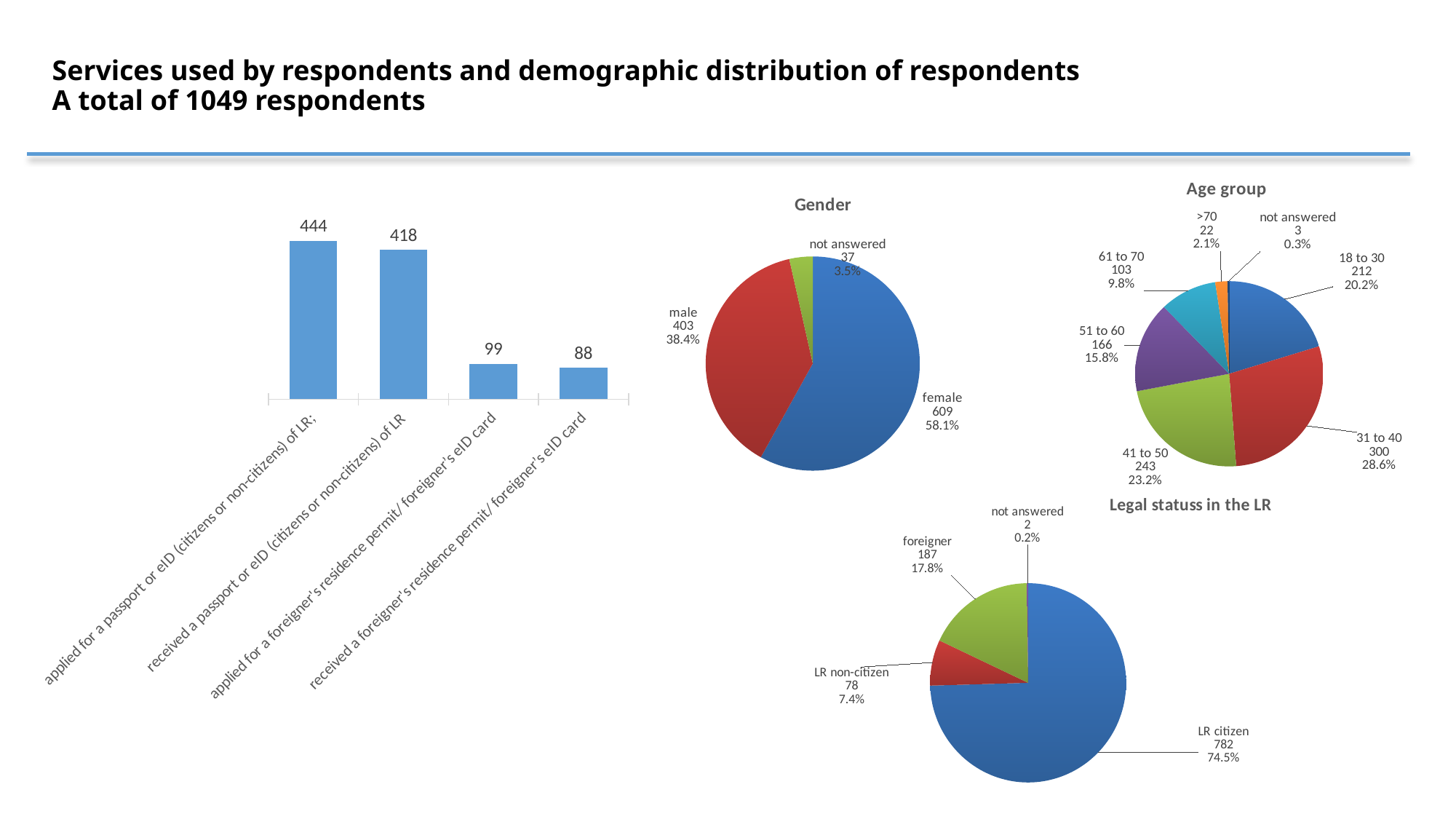
In the 'Legal statuss in the LR' pie chart, how many slices are there? 4 In the 'Legal statuss in the LR' pie chart, what share of respondents are LR citizens? 74.5% In the 'Gender' pie chart, what share of respondents are female? 58.1% How many bars are in the bar chart on the left? 4 In the 'Age group' pie chart, which is larger: '18 to 30' or '41 to 50'? 41 to 50 In the bar chart on the left, what is the difference between the values for 'applied for a passport or eID' and 'received a passport or eID'? 26 What kind of chart is the 'Gender' chart? pie chart In the bar chart on the left, what is the value for 'applied for a passport or eID (citizens or non-citizens) of LR'? 444 In the 'Gender' pie chart, how many respondents are male? 403 In the 'Age group' pie chart, what is the value for '51 to 60'? 166 In the 'Age group' pie chart, which age group has the largest number of respondents? 31 to 40 In the bar chart on the left, which category has the lowest value? received a foreigner's residence permit/ foreigner's eID card